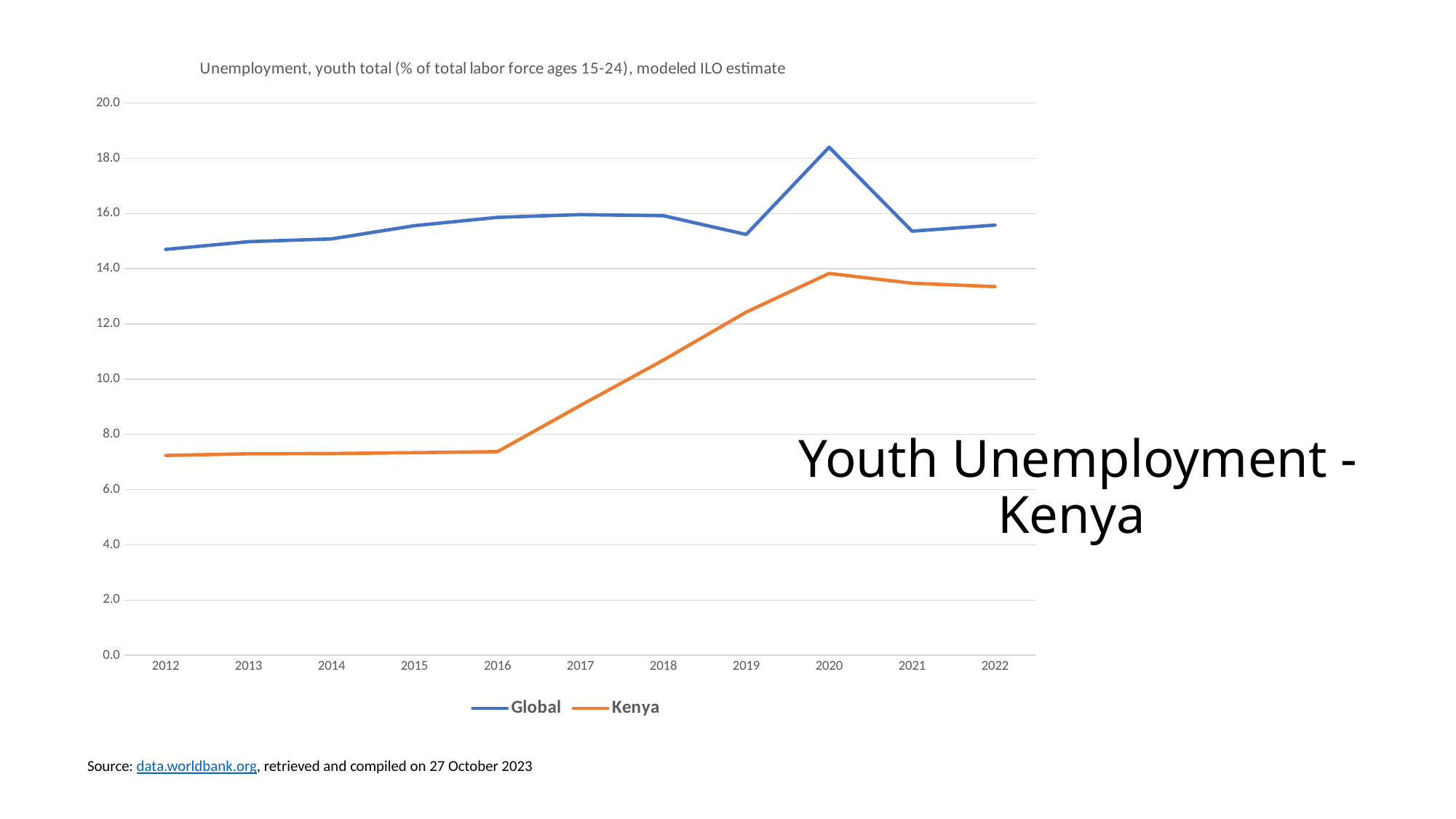
Which series has the larger value in 2020, Global or Kenya? Global Is the Global value for 2020 greater or less than 18.0? greater In which year does the Global series reach its highest value? 2020 Is the Kenya value for 2016 greater or less than 8.0? less Does the Kenya series rise or fall between 2016 and 2020? rise What kind of chart is shown on the slide? line chart Which series is drawn in orange? Kenya How many series does the legend list? 2 Is the Kenya value for 2022 greater or less than 12.0? greater Does the Global series rise or fall between 2020 and 2021? fall How many years are shown along the x axis? 11 In which year does the Kenya series reach its highest value? 2020